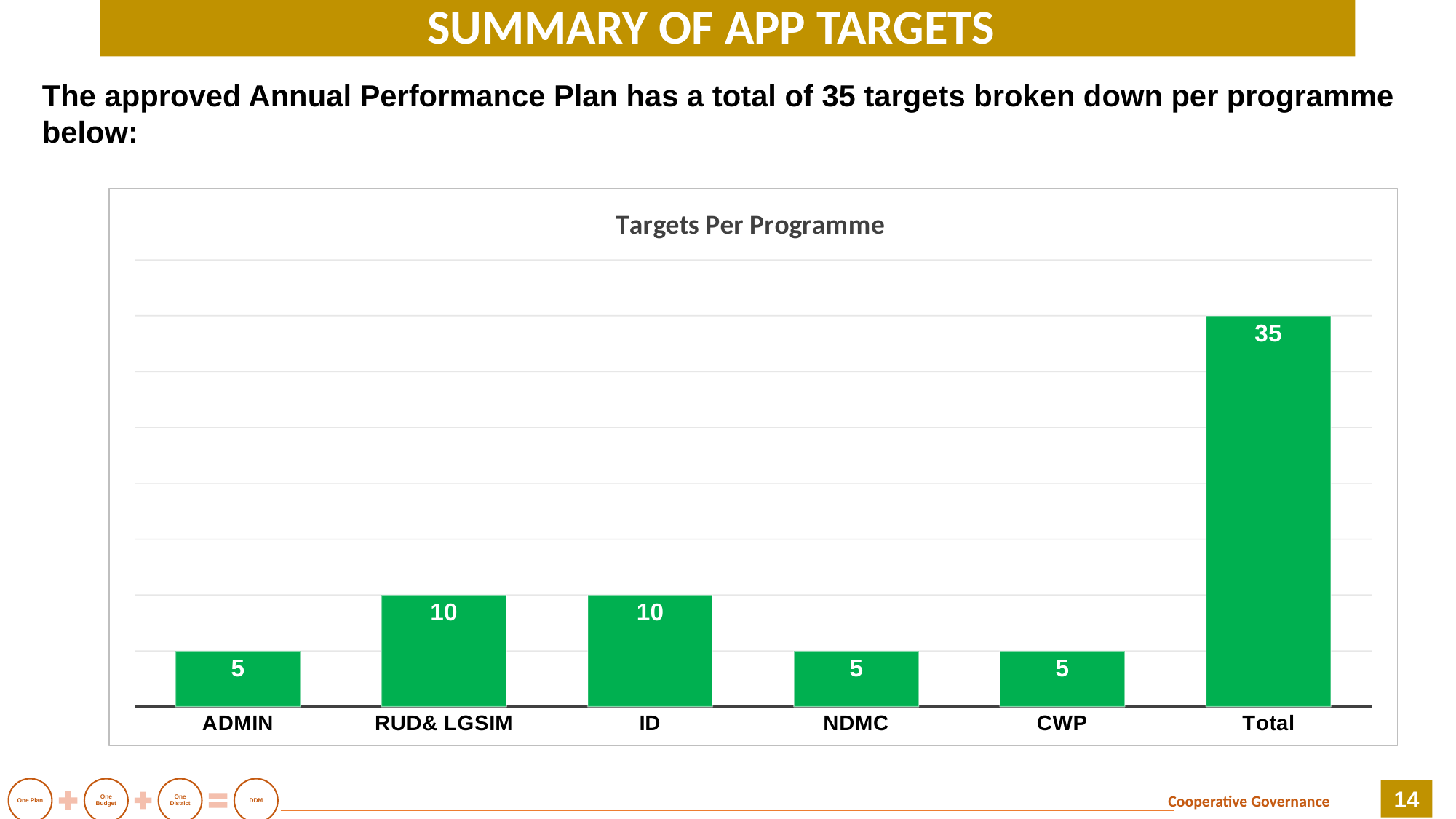
What is the value for NDMC? 5 What is the title of the chart? Targets Per Programme Which category has the highest value? Total What is the value for ADMIN in the Targets Per Programme chart? 5 What is the value for CWP? 5 What is the value for ID? 10 What is the difference between the values for RUD& LGSIM and ADMIN? 5 What is the value for RUD& LGSIM? 10 What kind of chart is shown on the slide? Bar chart Which is larger, the value for ID or the value for NDMC? ID What is the value of the Total bar? 35 How many categories are shown on the x axis? 6